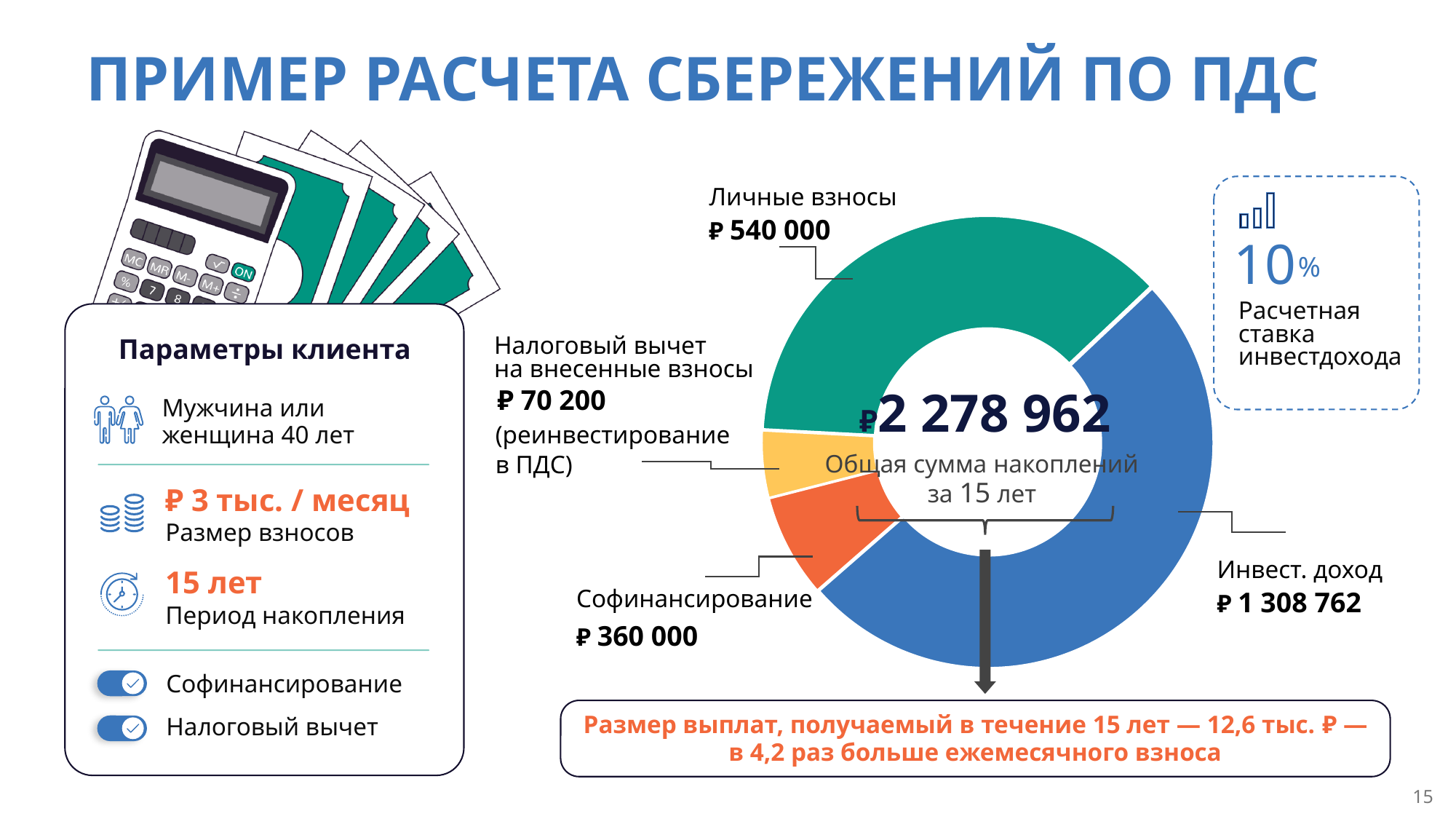
Which segment of the pie chart is the smallest? Налоговый вычет на внесенные взносы What colour is the Инвест. доход segment of the pie chart? blue What is the total sum shown in the centre of the pie chart? ₽2 278 962 What is the value for Налоговый вычет на внесенные взносы? ₽ 70 200 What is the value for Инвест. доход? ₽ 1 308 762 What is the value for Личные взносы? ₽ 540 000 Which segment of the pie chart is the largest? Инвест. доход What type of chart is shown on the slide? pie chart Which is larger, Личные взносы or Софинансирование? Личные взносы What is the value for Софинансирование? ₽ 360 000 How many segments does the pie chart have? 4 What is the difference between Личные взносы and Софинансирование? ₽ 180 000